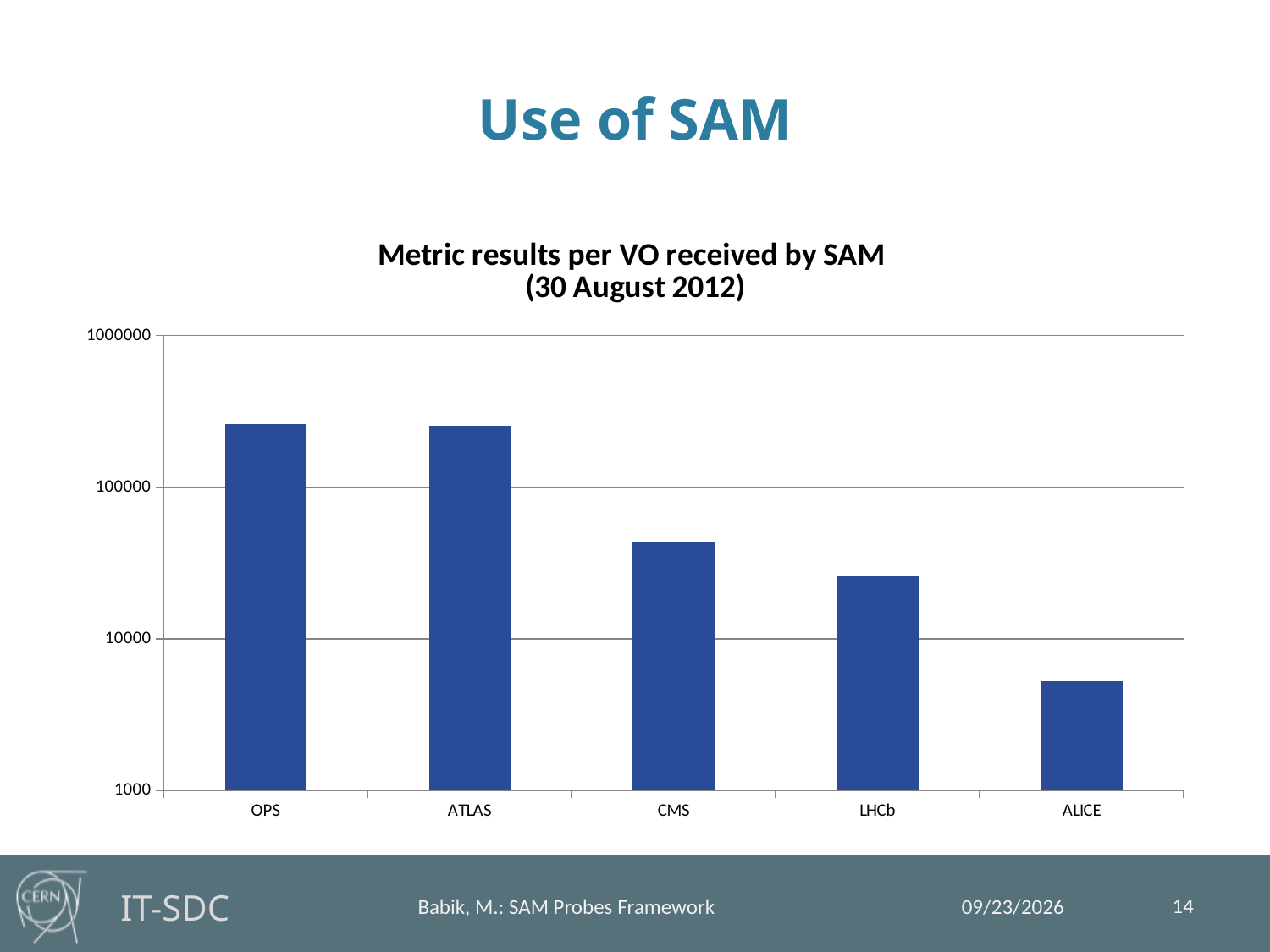
Which has more metric results received by SAM, CMS or LHCb? CMS What is the title of the chart? Metric results per VO received by SAM (30 August 2012) What kind of chart is shown on the slide? bar chart Is the value for CMS greater or less than 100000? less Which VO has the lowest number of metric results received by SAM? ALICE Is the value for CMS greater or less than 10000? greater Is the value for LHCb greater or less than 10000? greater Which has more metric results received by SAM, ATLAS or CMS? ATLAS Do the bar values rise or fall moving from left to right along the x axis? fall How many VOs (categories) are shown on the x axis of the chart? 5